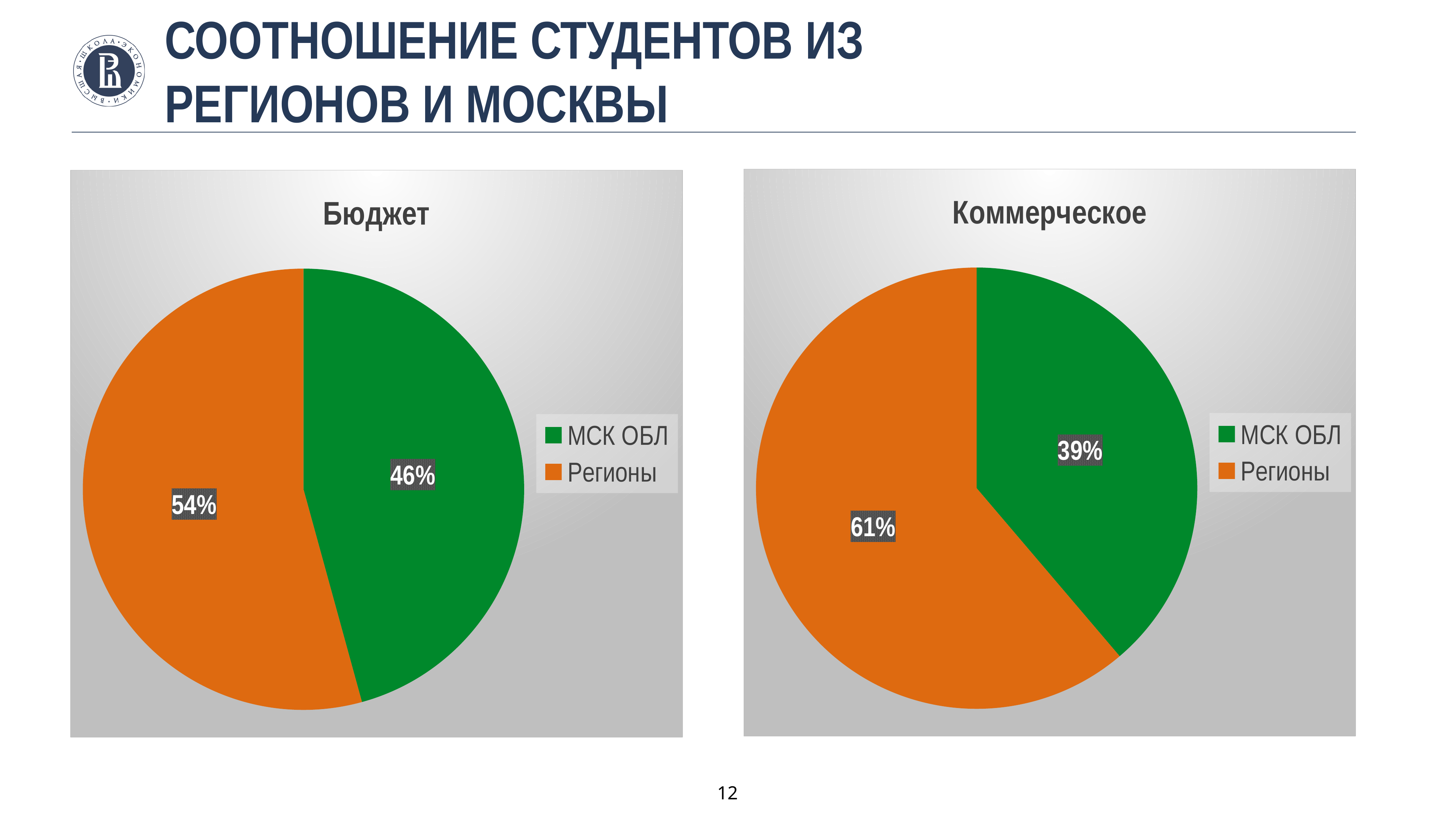
In the "Коммерческое" chart, which category has the smallest slice? МСК ОБЛ How many categories does the "Бюджет" chart show? 2 In the "Бюджет" chart, what share does Регионы have? 54% In the "Коммерческое" chart, what is the difference between the Регионы and МСК ОБЛ shares? 22% In the "Бюджет" chart, what colour represents Регионы? Orange Which is larger: the МСК ОБЛ share in the "Бюджет" chart or the МСК ОБЛ share in the "Коммерческое" chart? Бюджет In the "Бюджет" chart, which category has the largest slice? Регионы In the "Бюджет" chart, what is the difference between the Регионы and МСК ОБЛ shares? 8% In the "Коммерческое" chart, what share does МСК ОБЛ have? 39% In the "Бюджет" chart, what share does МСК ОБЛ have? 46% What type of chart is the "Коммерческое" chart? Pie chart